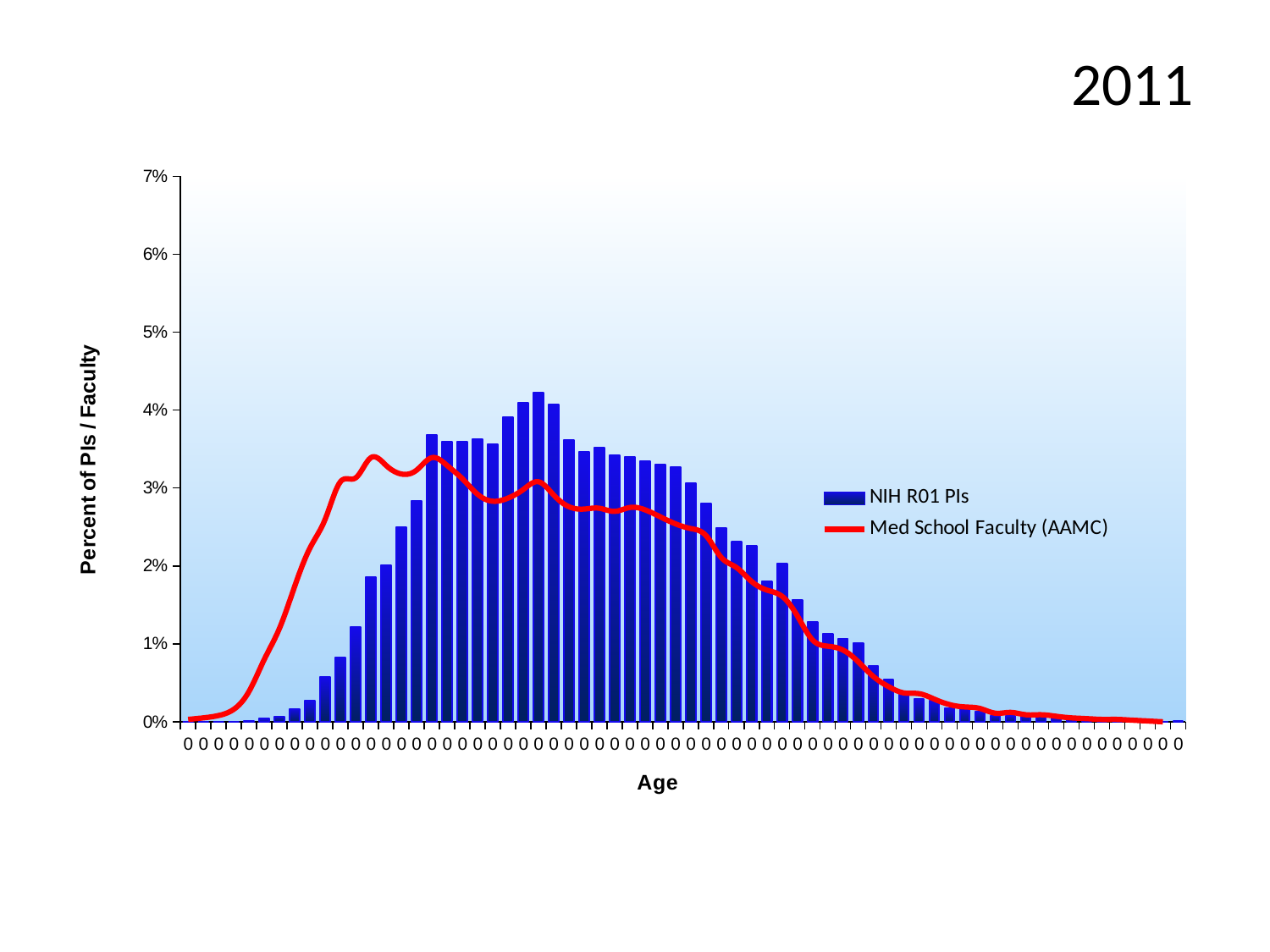
Do the NIH R01 PIs bars rise or fall along the right-hand half of the x axis? fall Is the highest point of the Med School Faculty (AAMC) line greater or less than 3%? greater What is the title of the vertical axis? Percent of PIs / Faculty What kind of chart is shown on the slide? A combined bar and line chart Is the tallest NIH R01 PIs bar greater or less than 5%? less How many series does the legend list? 2 Which series reaches a higher peak value, NIH R01 PIs or Med School Faculty (AAMC)? NIH R01 PIs Is the tallest NIH R01 PIs bar greater or less than 4%? greater Which series is drawn as bars? NIH R01 PIs